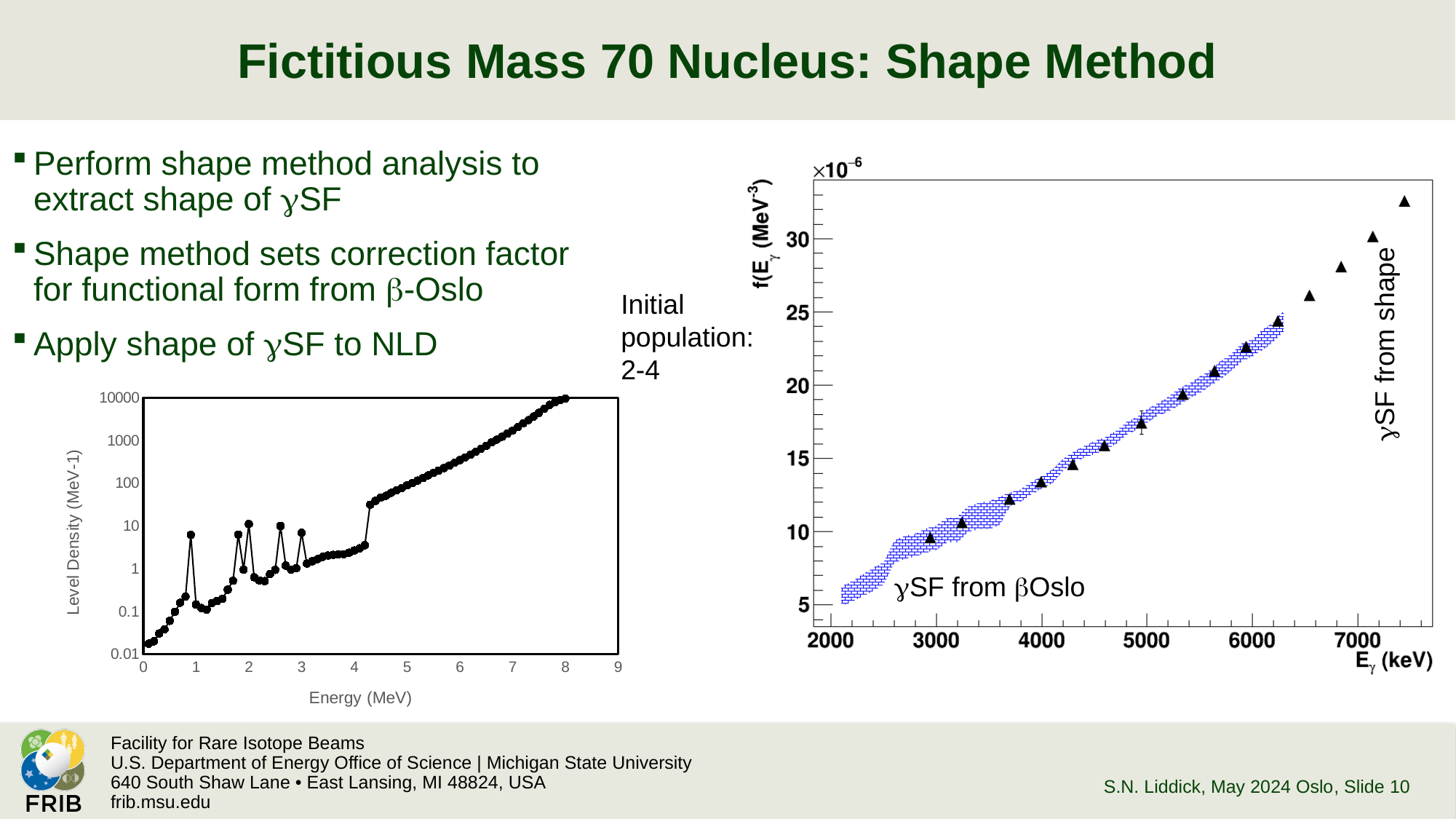
On the left chart, what is the highest tick value shown on the x axis? 9 On the right chart, is the γSF from shape value at about 7400 keV greater or less than 30? greater On the left chart, is the level density at 0 MeV greater or less than 0.1? less On the right chart, do the γSF from shape triangles rise or fall as Eγ increases? rise On the right chart, what is the label of the x axis? Eγ (keV) On the left chart, does the level density overall rise or fall as energy increases from 4.5 MeV to 8 MeV? rise On the right chart, which data set is drawn as a blue hatched band? γSF from βOslo What kind of chart is the left chart of level density versus energy? line chart with markers On the left chart, is the level density at 8 MeV greater or less than 1000? greater